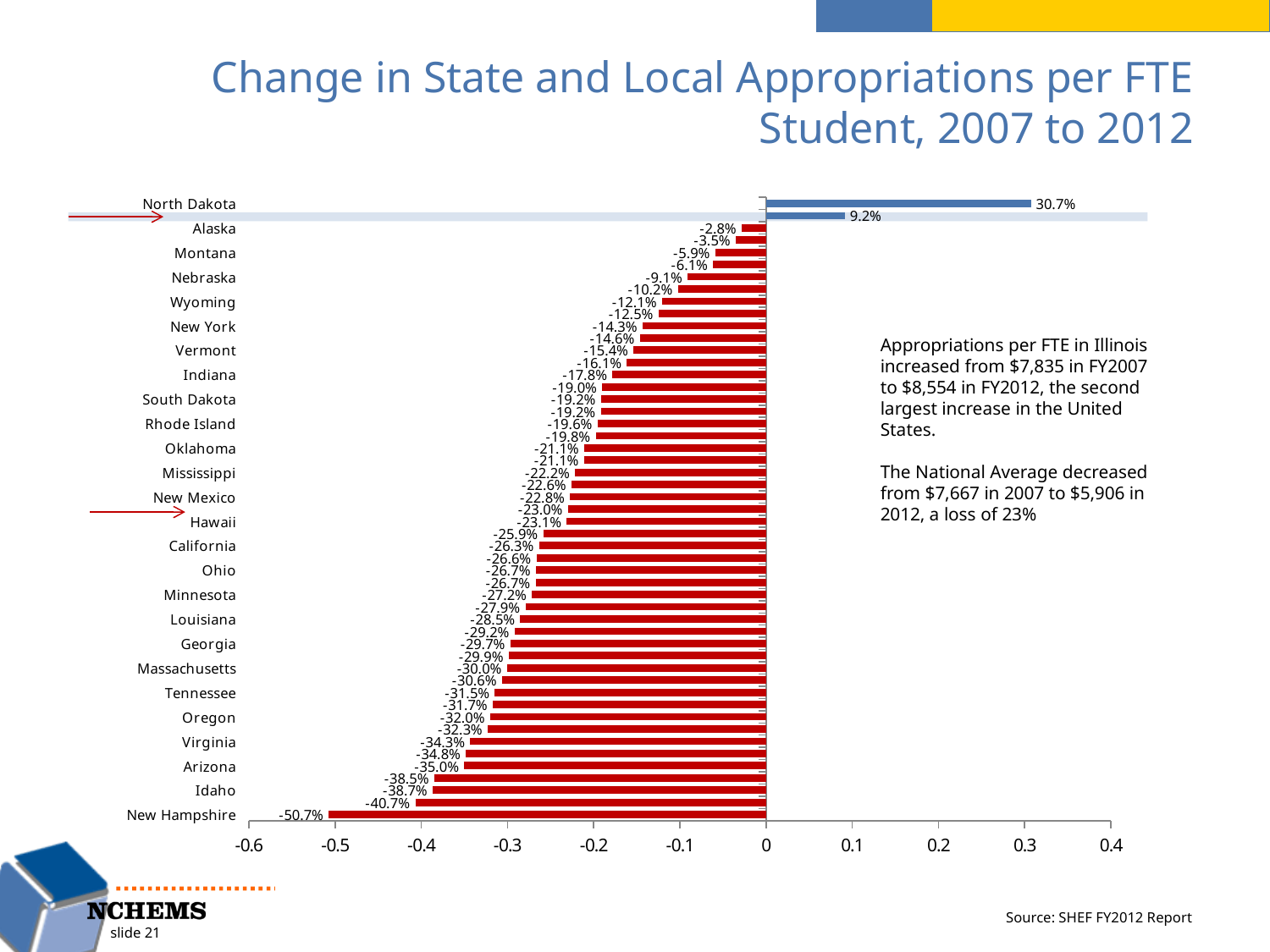
What is the title of the chart? Change in State and Local Appropriations per FTE Student, 2007 to 2012 Which state has the highest change in appropriations per FTE student? North Dakota What is the difference in percentage points between North Dakota's value and New Hampshire's value? 81.4 percentage points Is the value for North Dakota greater or less than 0.2? greater What is the value for North Dakota? 30.7% What colour are the bars for states with negative values? Red Is the value for New Hampshire greater or less than -0.4? less What is the value for New Hampshire? -50.7% What kind of chart is shown on the slide? Bar chart Which state has the lowest change in appropriations per FTE student? New Hampshire Which is larger, the value for North Dakota or the value for Alaska? North Dakota What is the value for Alaska? -2.8%